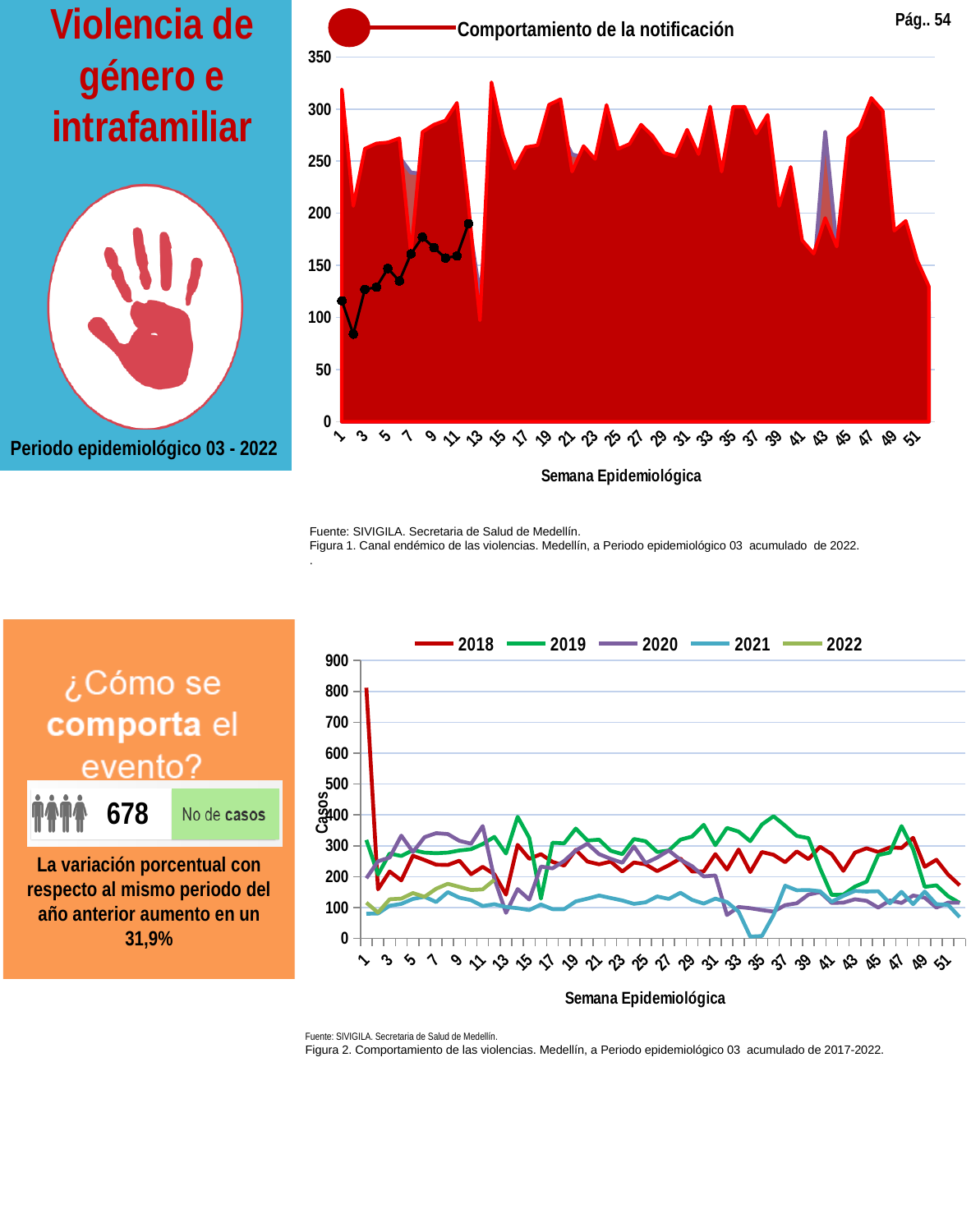
In the bottom chart, which series has the larger value at week 1, 2018 or 2019? 2018 In the bottom chart, is the value for 2021 at week 35 greater or less than 100? less In the bottom chart, is the value for 2018 at week 1 greater or less than 700? greater What is the x-axis title of the top chart? Semana Epidemiológica In the top chart, does the 'Comportamiento de la notificación' line generally rise or fall from week 1 to week 13? rise In the bottom chart, which series has the larger value at week 35, 2019 or 2021? 2019 In the bottom chart, which years are listed in the legend? 2018, 2019, 2020, 2021, 2022 How many series does the legend of the bottom chart list? 5 What type of chart is the bottom chart on the slide? line chart What is the title of the y axis of the bottom chart? Casos In the top chart, is the value of the 'Comportamiento de la notificación' line at week 1 greater or less than 150? less